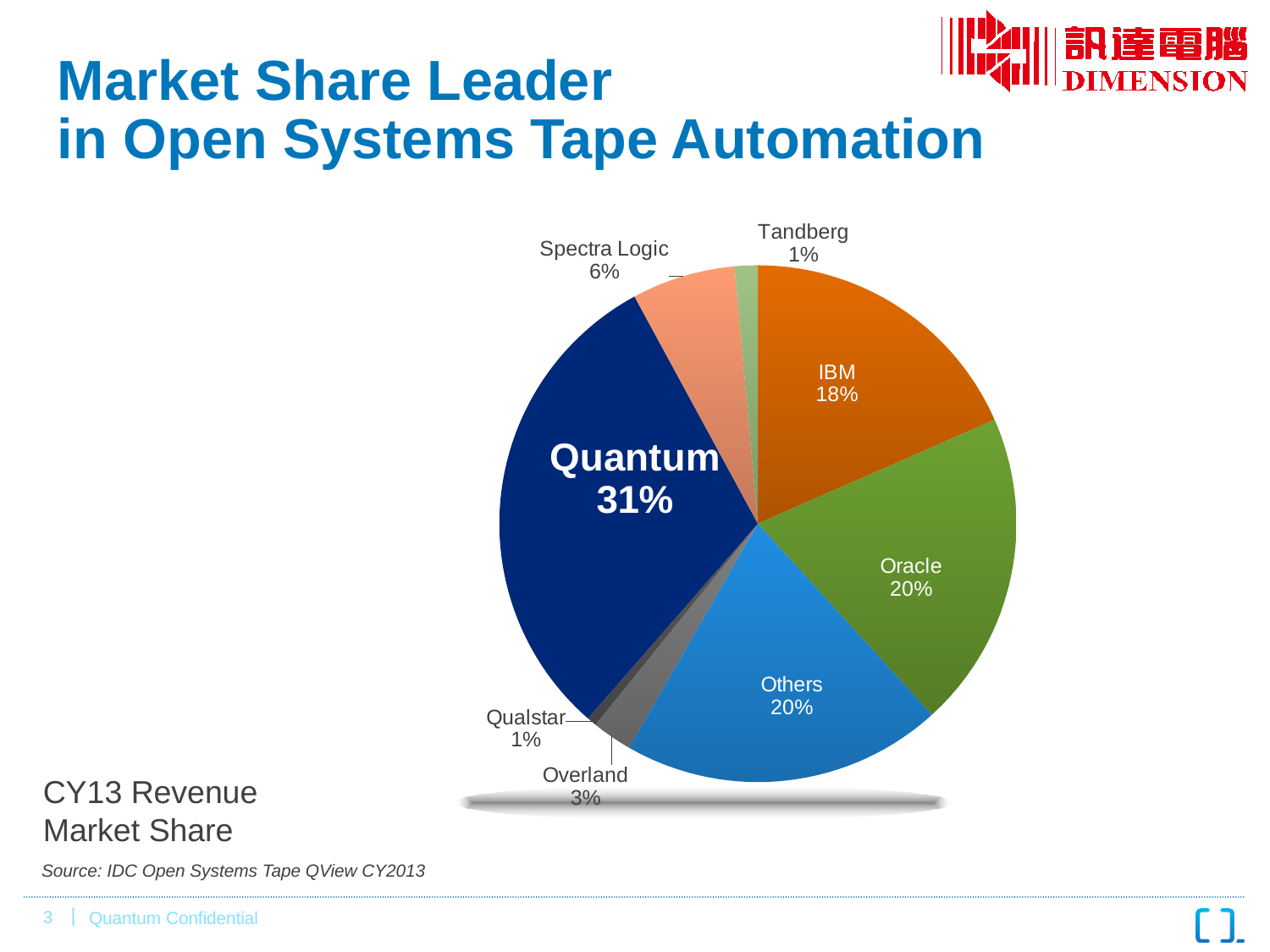
What is Quantum's share of the CY13 revenue market share pie? 31% What kind of chart is shown on the slide? Pie chart What source is cited for the chart data? IDC Open Systems Tape QView CY2013 What is IBM's share in the pie chart? 18% What is Overland's share in the pie chart? 3% Which is larger, IBM's share or Spectra Logic's share? IBM Which company has the largest slice of the pie chart? Quantum What is the difference between Quantum's share and Oracle's share? 11% How many slices does the pie chart have? 8 What is the difference between IBM's share and Overland's share? 15% What is Spectra Logic's share in the pie chart? 6% What is Oracle's share in the pie chart? 20%